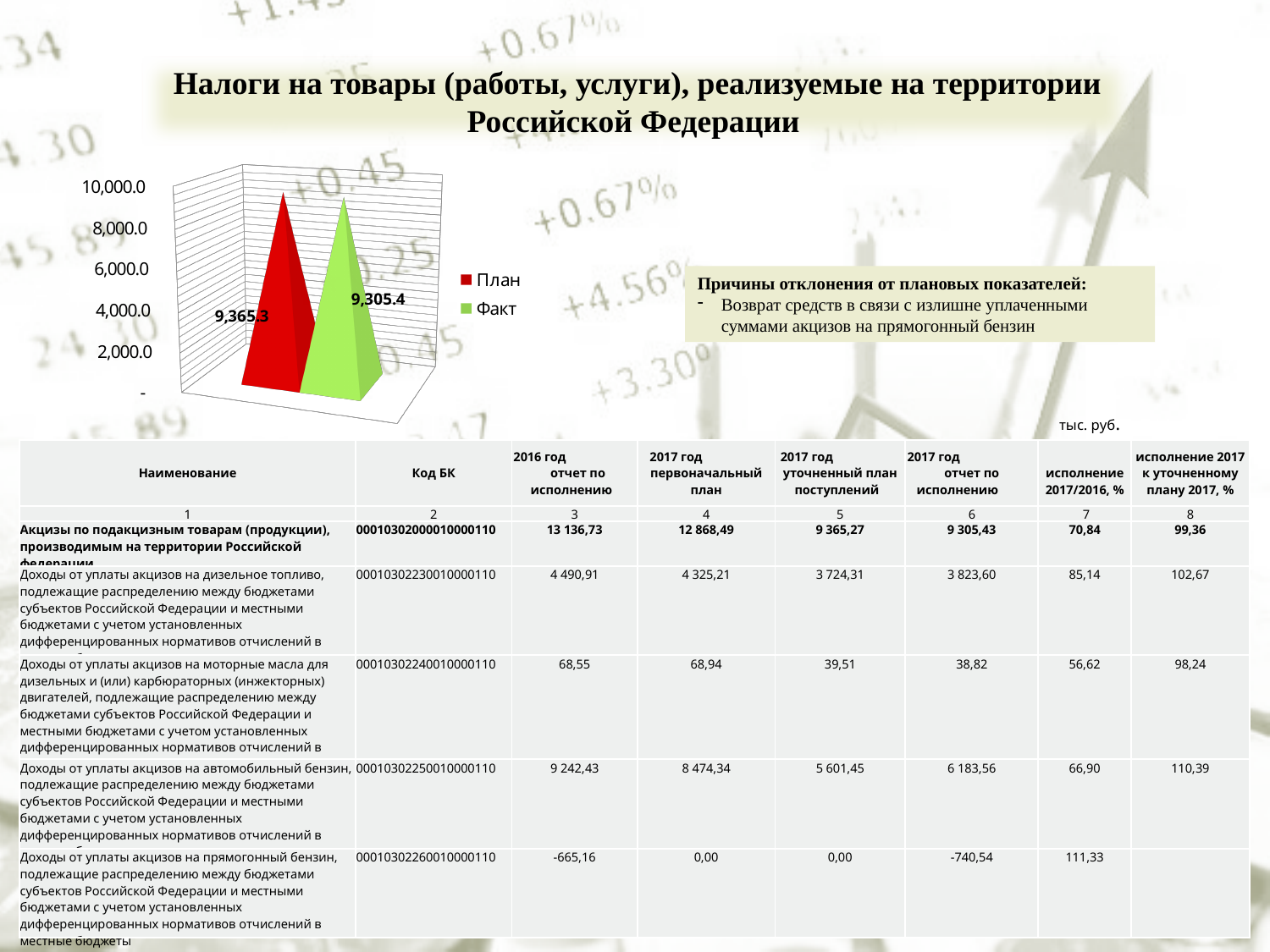
Is the value for План greater or less than 8,000.0? greater What kind of chart is shown on the slide? Bar chart What are the two entries in the chart legend? План and Факт What is the value of the План series on the chart? 9,365.3 How many bars are plotted on the chart? 2 Which is larger on the chart, План or Факт? План What is the difference between the План value and the Факт value on the chart? 59.9 How many series does the chart legend list? 2 Is the value for Факт greater or less than 10,000.0? less What is the value of the Факт series on the chart? 9,305.4 Which series has the highest value on the chart? План What colour represents the План series on the chart? Red